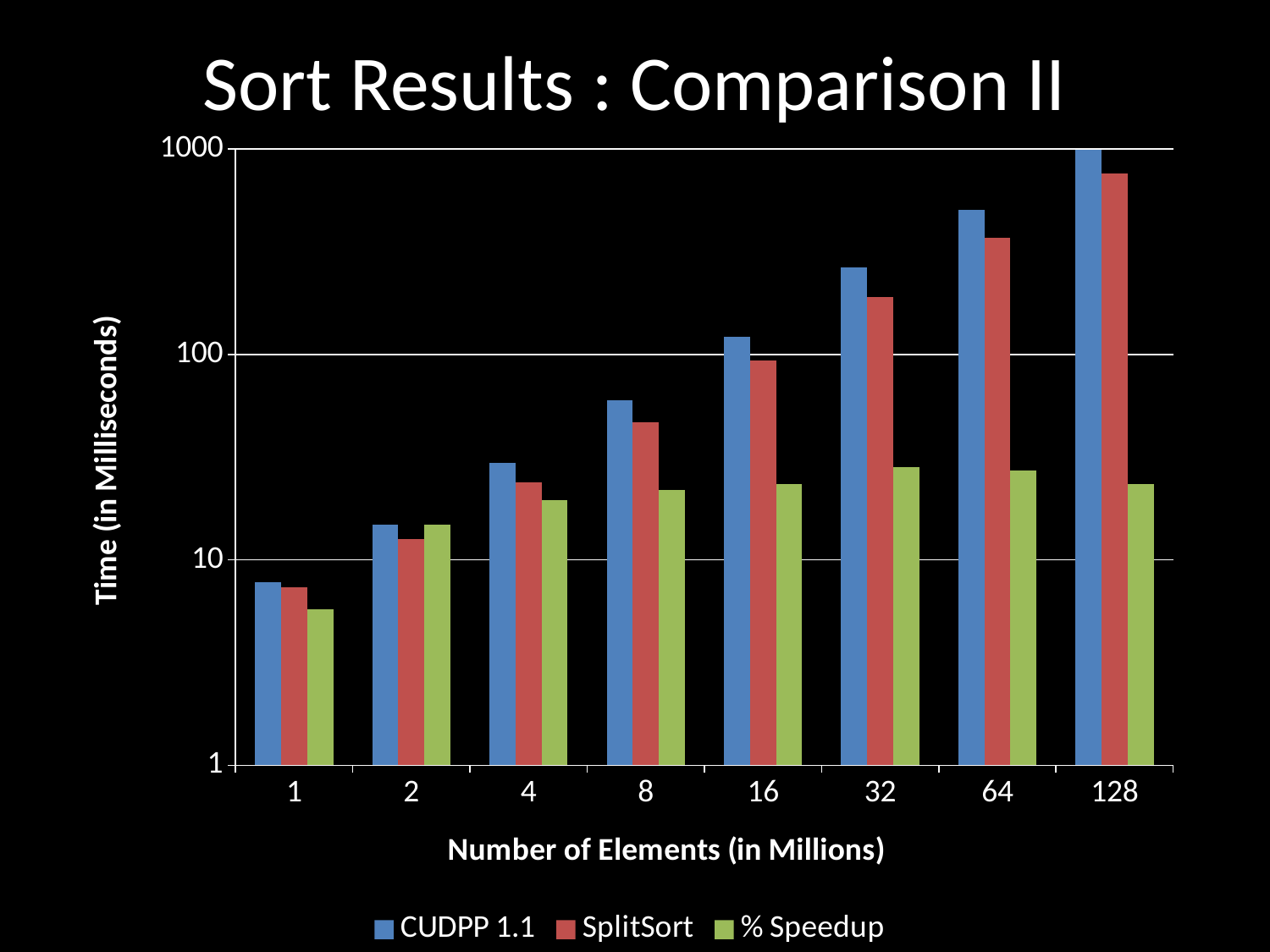
Do the CUDPP 1.1 values rise or fall as the number of elements increases? rise Is the % Speedup value for 128 million elements greater or less than 10? greater How many categories are shown on the x axis? 8 For which number of elements is the SplitSort time lowest? 1 For which number of elements is the CUDPP 1.1 time highest? 128 Is the CUDPP 1.1 value for 1 million elements greater or less than 10? less Is the SplitSort value for 64 million elements greater or less than 100? greater What is the title of the y axis? Time (in Milliseconds) What kind of chart is shown on the slide? bar chart At 128 million elements, which is larger: CUDPP 1.1 or SplitSort? CUDPP 1.1 How many series does the legend list? 3